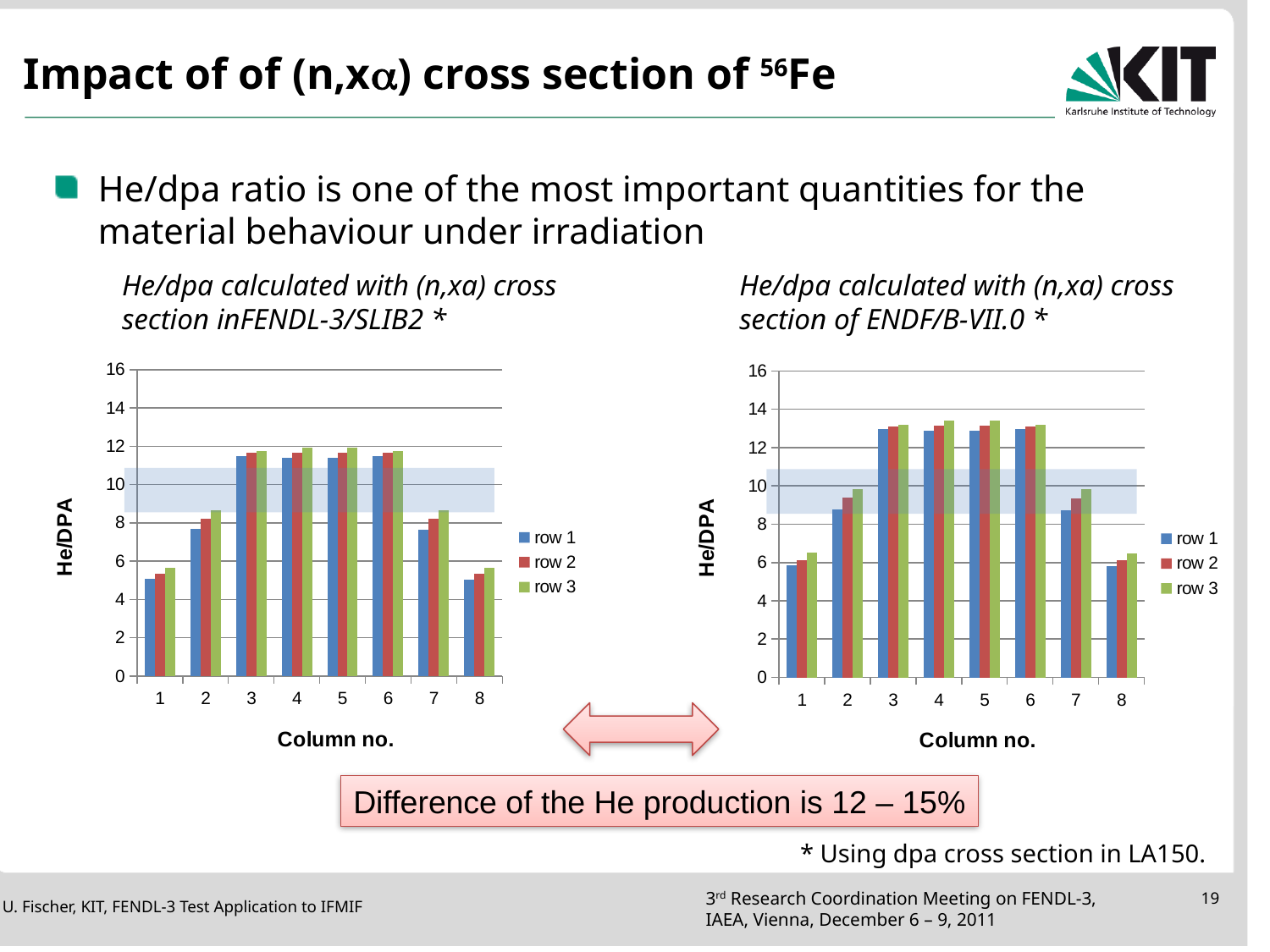
In the left chart (FENDL-3/SLIB2), is the row 1 value for column 1 greater or less than 6? less In the right chart (ENDF/B-VII.0), is the row 1 value for column 2 greater or less than 8? greater What is the y-axis label of the right chart? He/DPA How many column numbers are shown on the x axis of the right chart, 'He/dpa calculated with (n,xa) cross section of ENDF/B-VII.0'? 8 What is the x-axis label of the left chart? Column no. In the left chart (FENDL-3/SLIB2), is the row 1 value for column 7 greater or less than 8? less In the left chart (FENDL-3/SLIB2), which is larger for row 1: column 3 or column 1? column 3 What kind of chart is the left chart, 'He/dpa calculated with (n,xa) cross section in FENDL-3/SLIB2'? bar chart In the right chart (ENDF/B-VII.0), which series has the highest value for column 1? row 3 How many series does the legend of the left chart list? 3